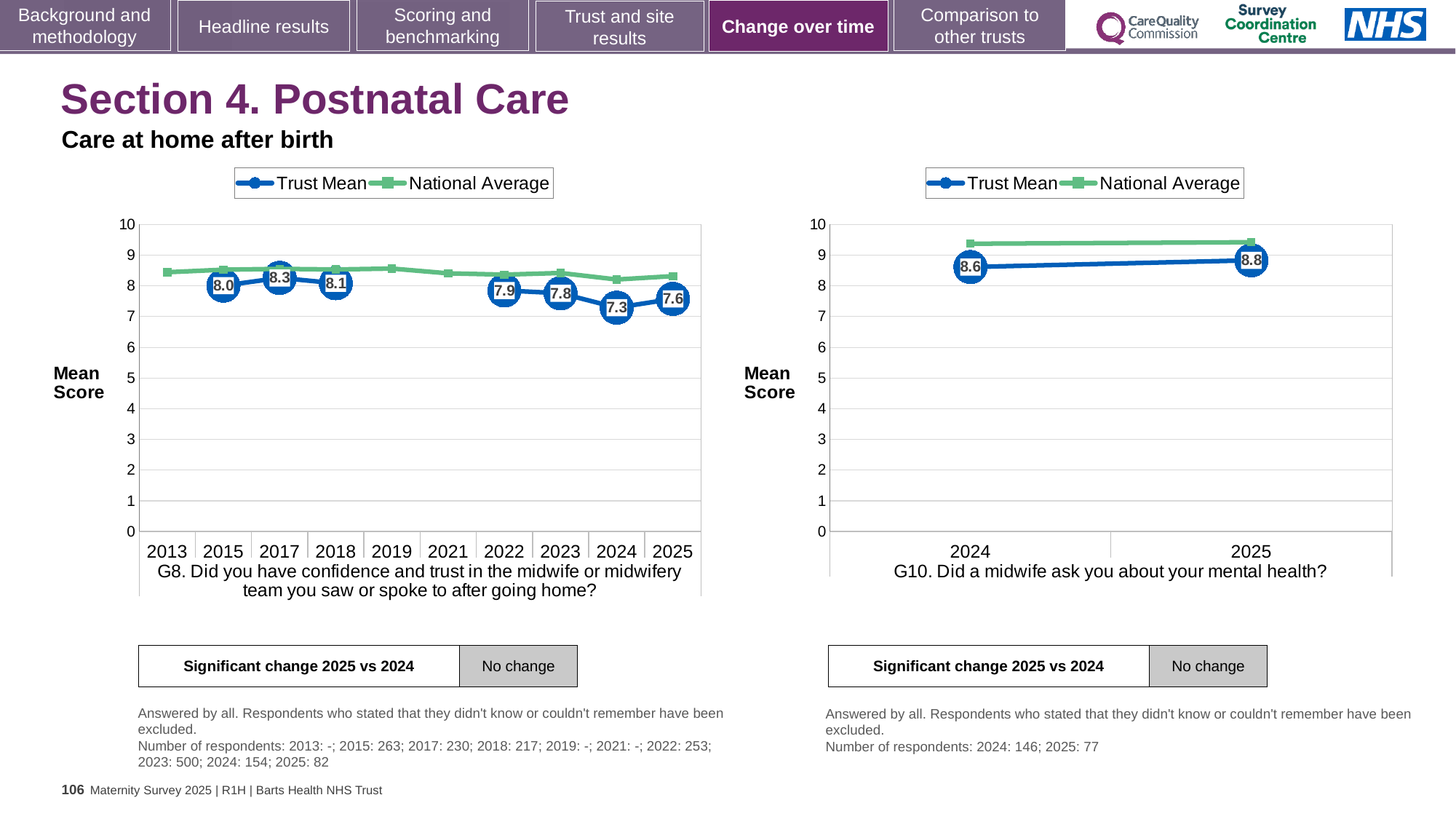
What kind of chart is the G8 chart? Line chart How many series does the legend of the G8 chart list? 2 In the G8 chart, what is the Trust Mean for 2017? 8.3 In the G10 chart, does the Trust Mean rise or fall from 2024 to 2025? Rise In the G10 chart, what is the difference between the Trust Mean for 2025 and 2024? 0.2 In the G8 chart, is the Trust Mean higher in 2023 or in 2024? 2023 In the G10 chart, what is the Trust Mean for 2024? 8.6 In the G8 chart, what is the Trust Mean for 2025? 7.6 In the G8 chart, which year has the highest Trust Mean? 2017 How many years are shown on the x axis of the G10 chart? 2 In the G10 chart, is the National Average for 2025 greater or less than 9? greater In the G8 chart, which year has the lowest Trust Mean? 2024